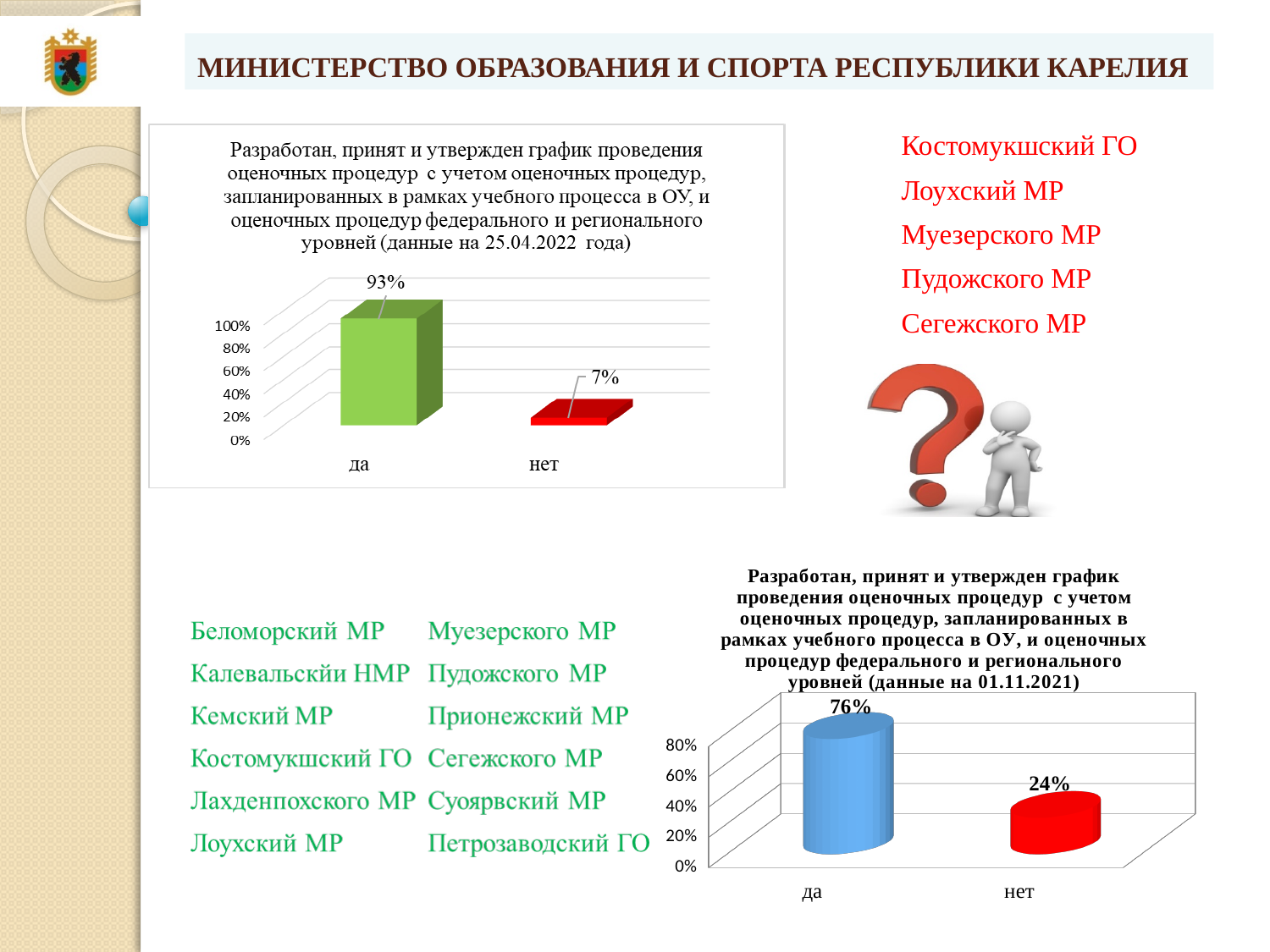
In the bottom-right chart (data as of 01.11.2021), which is larger, the value for "да" or for "нет"? да In the top-left chart (data as of 25.04.2022), what is the difference between the values for "да" and "нет"? 86% What kind of chart is the bottom-right chart (data as of 01.11.2021)? bar chart In the bottom-right chart (data as of 01.11.2021), what is the value for "да"? 76% In the bottom-right chart (data as of 01.11.2021), what is the difference between the values for "да" and "нет"? 52% In the top-left chart (data as of 25.04.2022), which category has the highest value? да In the top-left chart (data as of 25.04.2022), what is the value for "да"? 93% How many categories are shown in the top-left chart (data as of 25.04.2022)? 2 In the bottom-right chart (data as of 01.11.2021), what is the value for "нет"? 24% In the top-left chart (data as of 25.04.2022), what colour is the bar for "нет"? red In the top-left chart (data as of 25.04.2022), what is the value for "нет"? 7% In the bottom-right chart (data as of 01.11.2021), which category has the lowest value? нет